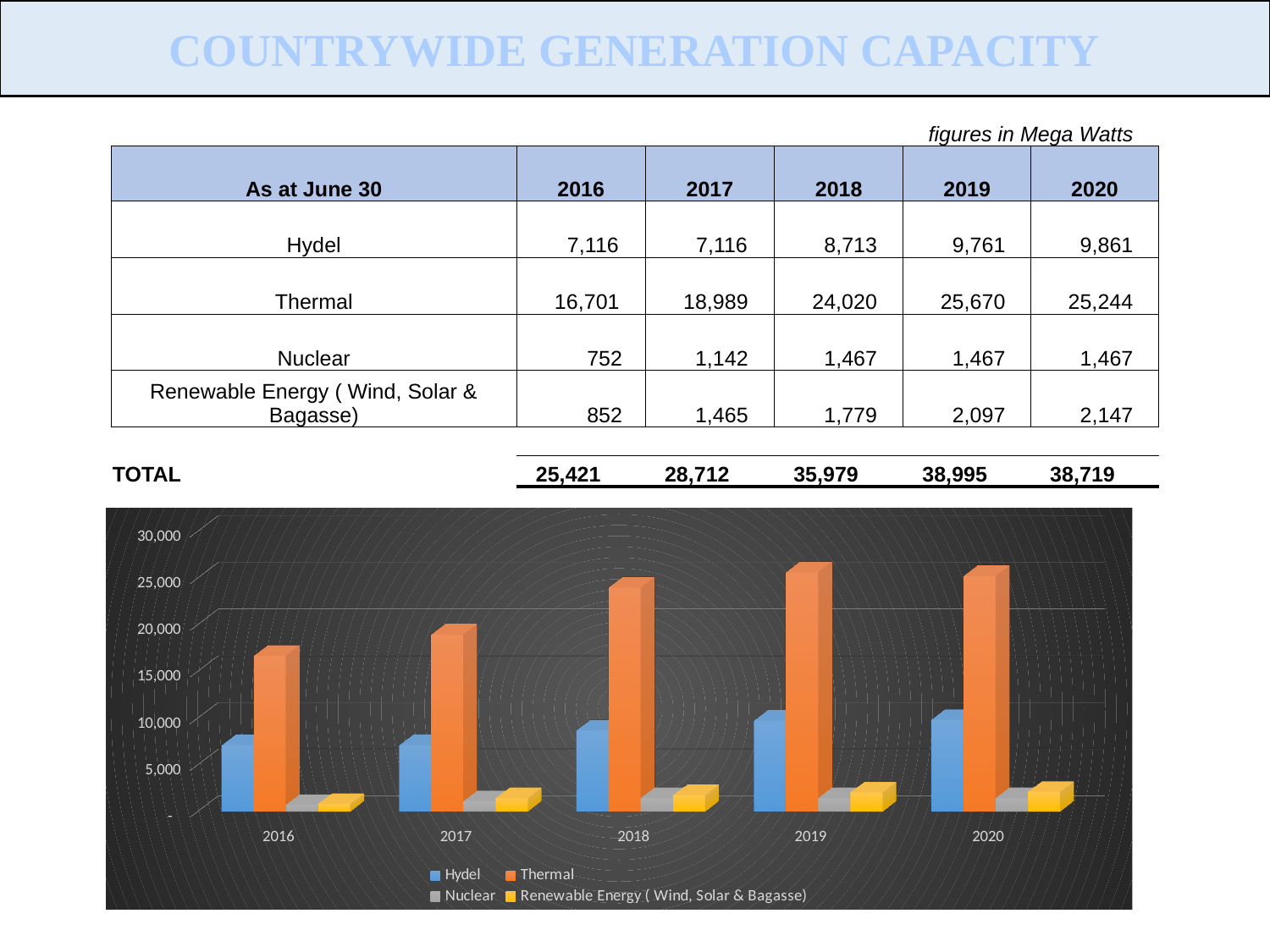
Does the Thermal series rise or fall from 2016 to 2019? rise What kind of chart is shown on the slide? bar chart In 2018, which is larger, the Hydel bar or the Thermal bar? Thermal Is the Thermal value for 2018 greater or less than 20,000? greater How many years are shown along the x axis of the chart? 5 What is the Nuclear generation capacity for 2020 as printed on the slide? 1,467 How many series does the chart legend list? 4 What is the difference between the Thermal values for 2019 and 2018 as printed on the slide? 1,650 Is the Hydel value for 2018 greater or less than 10,000? less In which year is the Thermal bar the lowest? 2016 Which series has the tallest bars in every year of the chart? Thermal What colour represents Thermal in the chart legend? orange